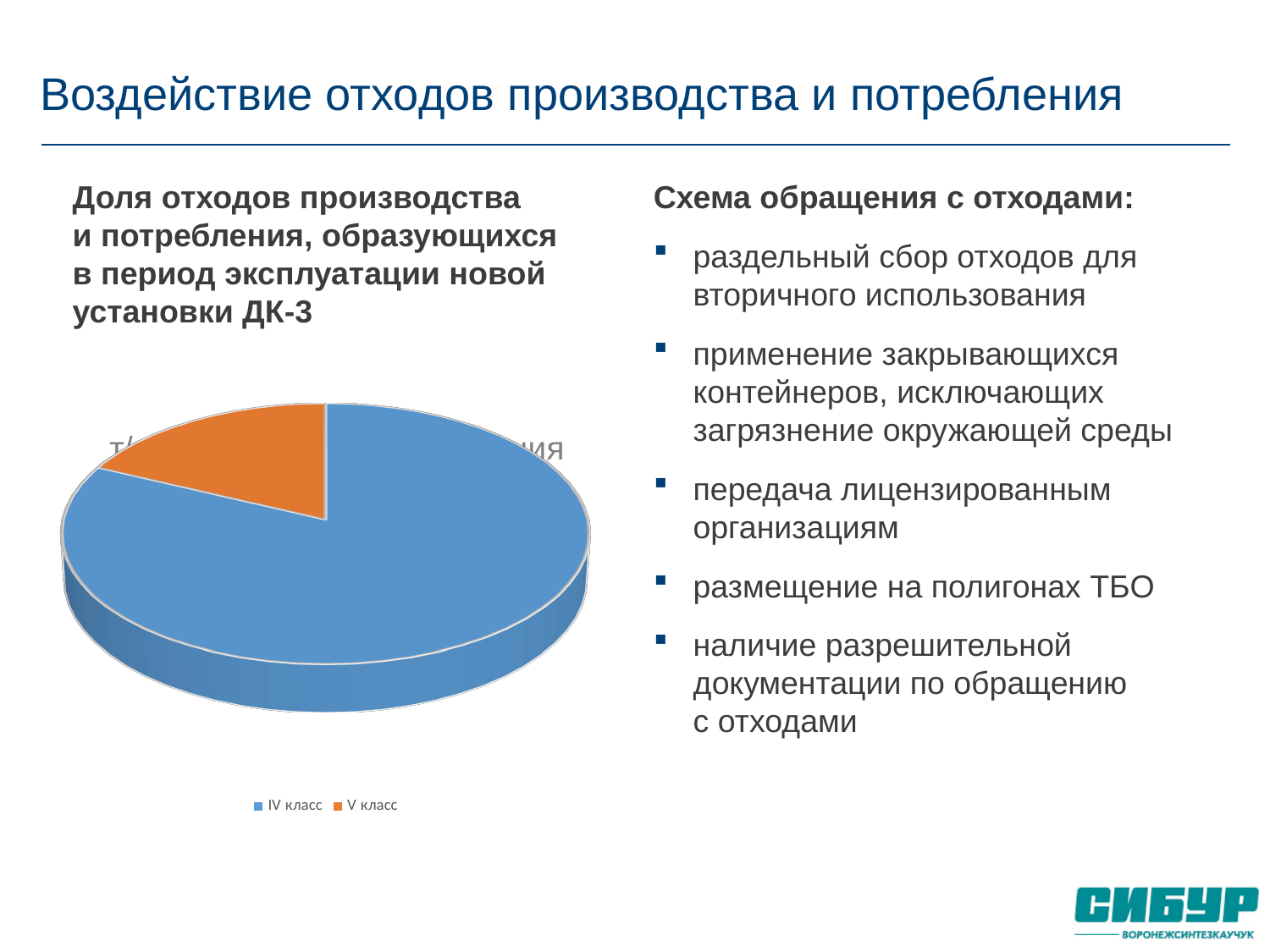
What colour is the slice for V класс in the pie chart? orange What kind of chart is shown on the slide? pie chart Which category has the largest slice in the pie chart? IV класс Which slice is larger in the pie chart, IV класс or V класс? IV класс How many slices does the pie chart have? 2 What colour is the slice for IV класс in the pie chart? blue Which category has the smallest slice in the pie chart? V класс How many entries does the legend of the pie chart list? 2